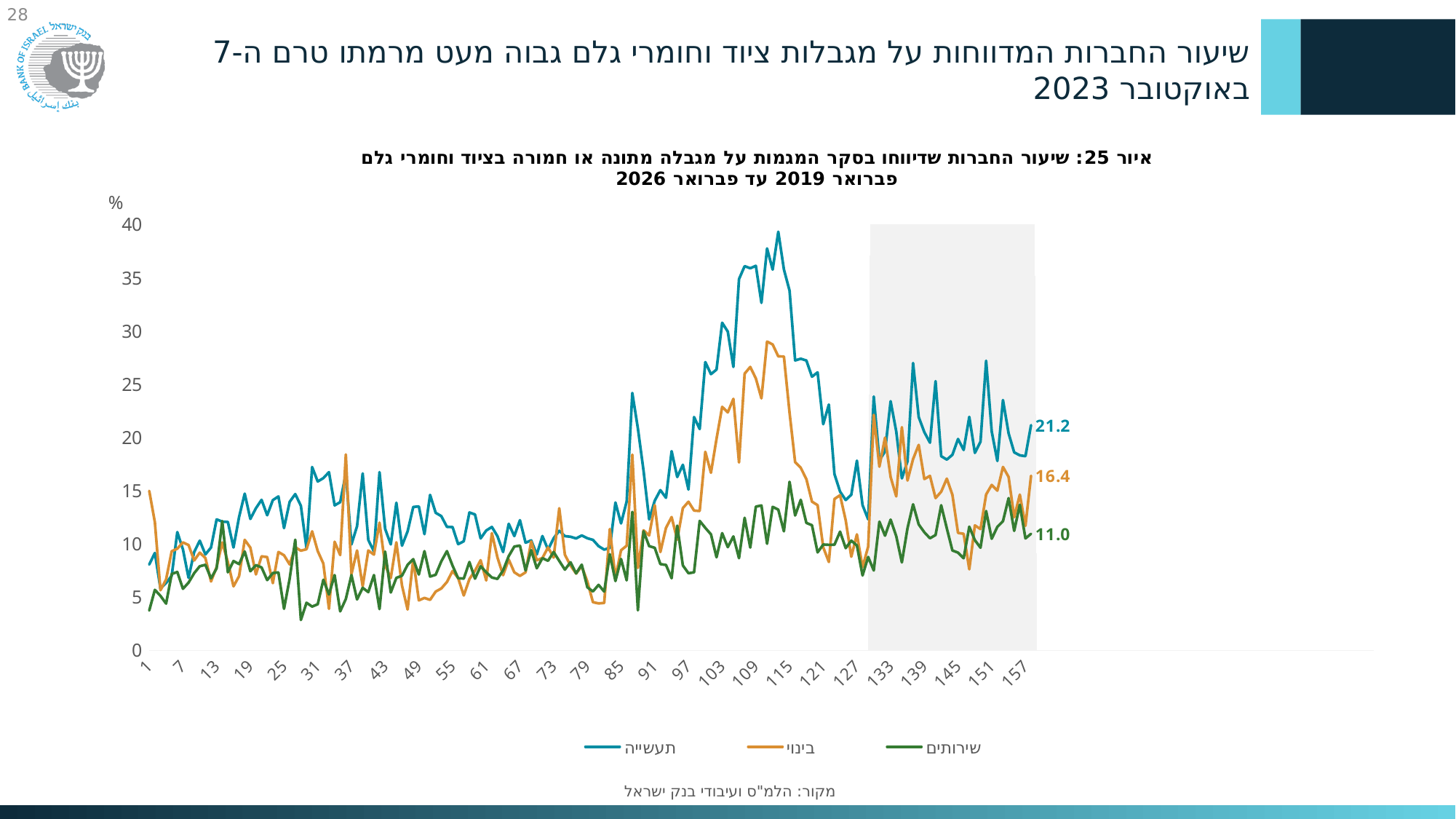
Is the highest value reached by the שירותים series greater or less than 20? less What is the final labelled value of the בינוי series? 16.4 Which series has the lowest final labelled value? שירותים What is the final labelled value of the תעשייה series? 21.2 What type of chart is shown on the slide? line chart What is the difference between the final labelled values of תעשייה and בינוי? 4.8 What is the difference between the final labelled values of בינוי and שירותים? 5.4 Which series has the highest final labelled value? תעשייה What is the final labelled value of the שירותים series? 11.0 Is the peak value of the תעשייה series greater or less than 35? greater How many series does the legend list? 3 What unit is shown on the vertical axis? %